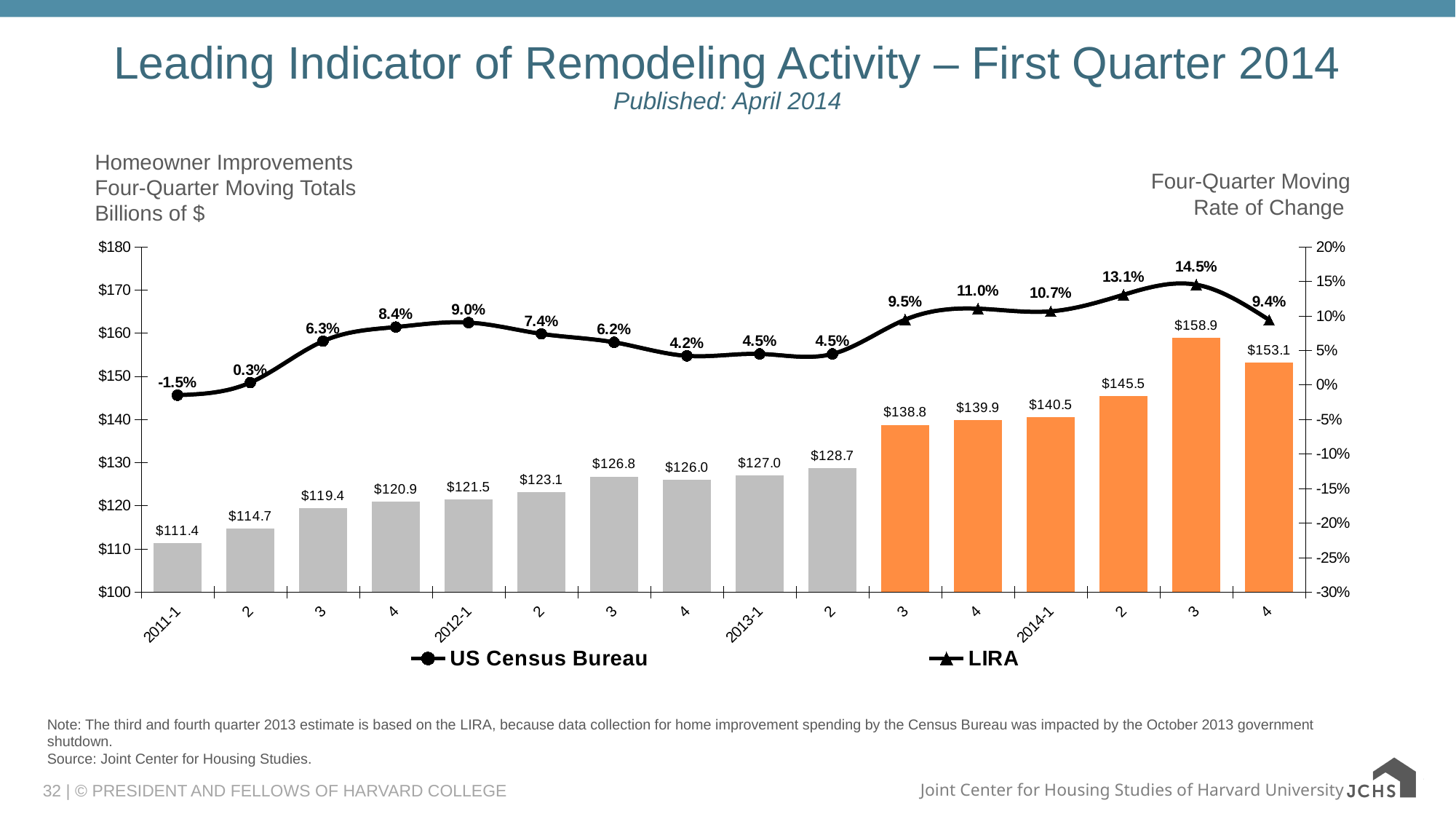
What are the two series named in the legend? US Census Bureau and LIRA What kind of chart is shown on the slide? Combined bar and line chart Which quarter has the highest four-quarter moving total bar? 2014-3 Which has the larger four-quarter moving total, 2012-3 or 2012-4? 2012-3 What is the four-quarter moving rate of change shown for 2012-1? 9.0% Do the four-quarter moving total bars rise or fall from 2013-2 to 2014-3? Rise How many series does the legend list? 2 What is the four-quarter moving total for the third quarter of 2014 (2014-3)? $158.9 How many quarters are plotted along the x axis? 16 What is the rate of change shown for the fourth quarter of 2014 (2014-4)? 9.4% What is the difference between the four-quarter moving totals for 2014-3 and 2014-4? $5.8 Which quarter has the lowest four-quarter moving rate of change? 2011-1